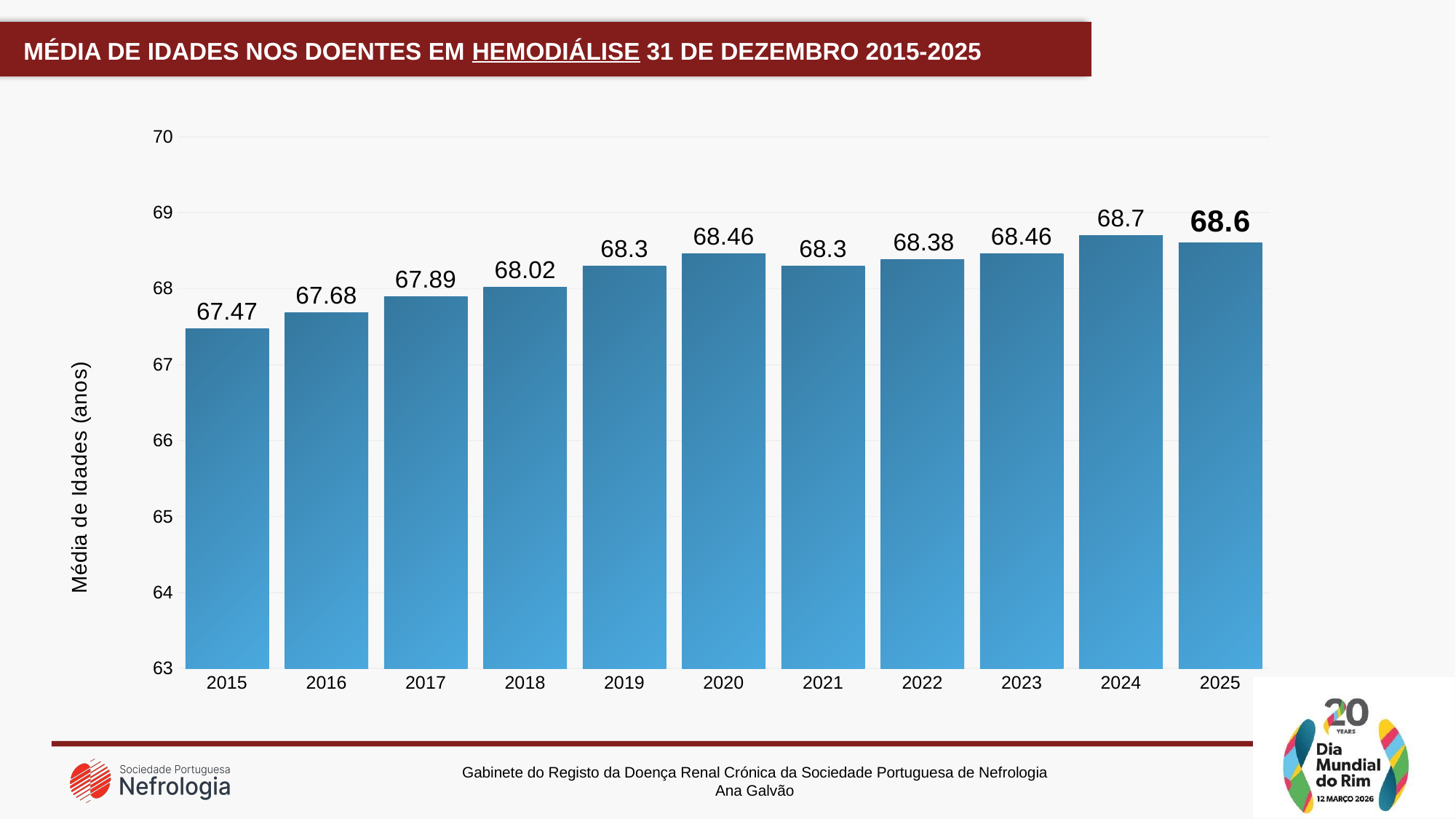
Which is larger, the average age in 2022 or in 2021? 2022 Which year has the lowest average age? 2015 What kind of chart is shown on the slide? bar chart Which year has the highest average age? 2024 What is the average age of hemodialysis patients in 2018? 68.02 Is the value for 2017 greater or less than 68? less What is the label of the vertical axis? Média de Idades (anos) How many years are shown on the chart? 11 Do the values generally rise or fall from 2015 to 2024? rise What is the average age of hemodialysis patients in 2025? 68.6 What is the average age of hemodialysis patients in 2015? 67.47 What is the difference between the average age in 2024 and in 2015? 1.23